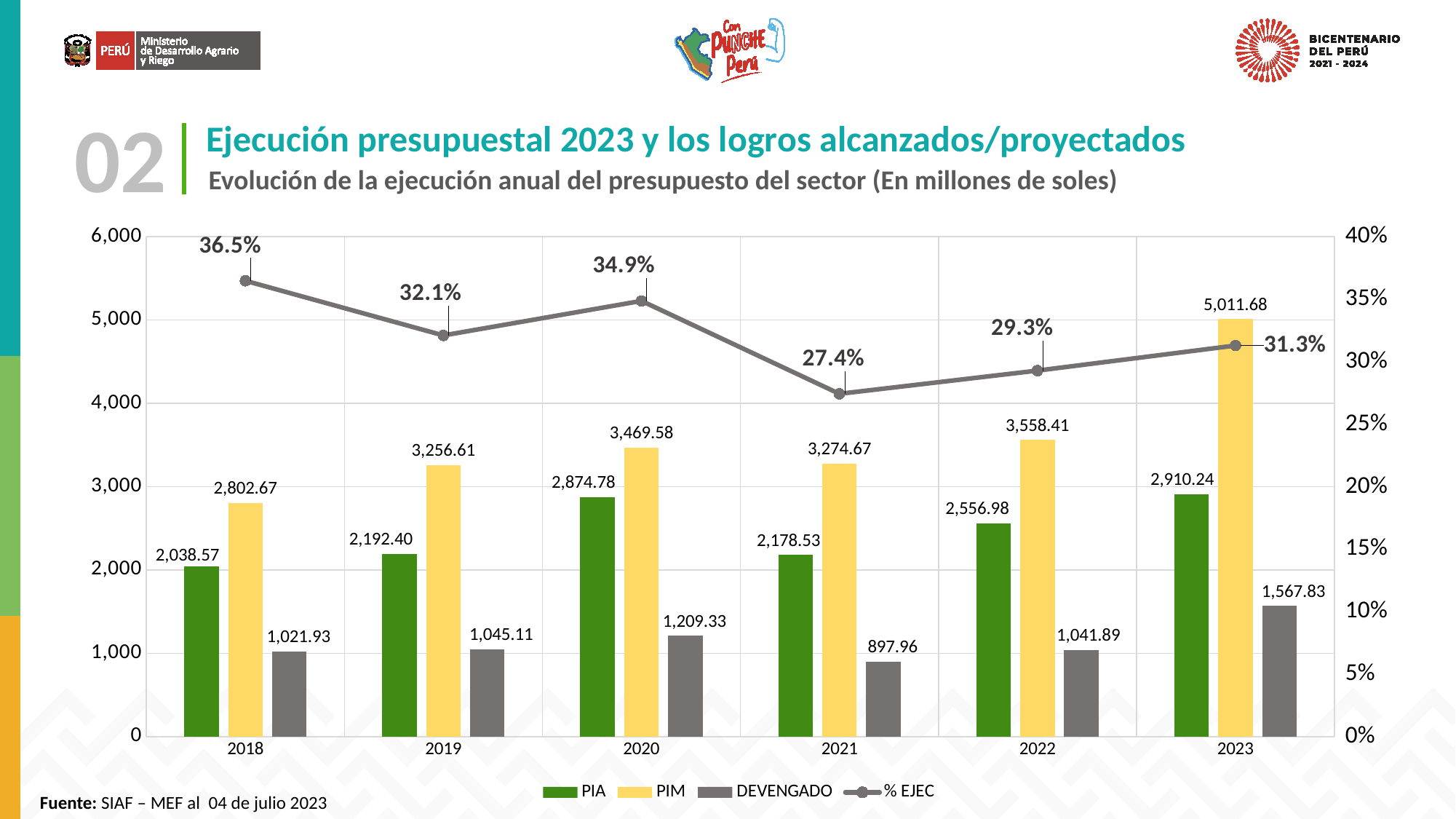
Which year has the lowest % EJEC value? 2021 What is the PIM value for 2023? 5,011.68 What is the DEVENGADO value for 2021? 897.96 What kind of chart is shown on the slide? Combined bar and line chart Does the % EJEC line rise or fall from 2018 to 2021? Fall Which year has the highest PIM value? 2023 How many years are shown on the x axis? 6 What is the % EJEC value for 2018? 36.5% Which is larger, the DEVENGADO value for 2020 or for 2019? 2020 What is the PIA value for 2020? 2,874.78 What is the difference between the PIM and PIA values for 2022? 1,001.43 How many series does the legend list? 4